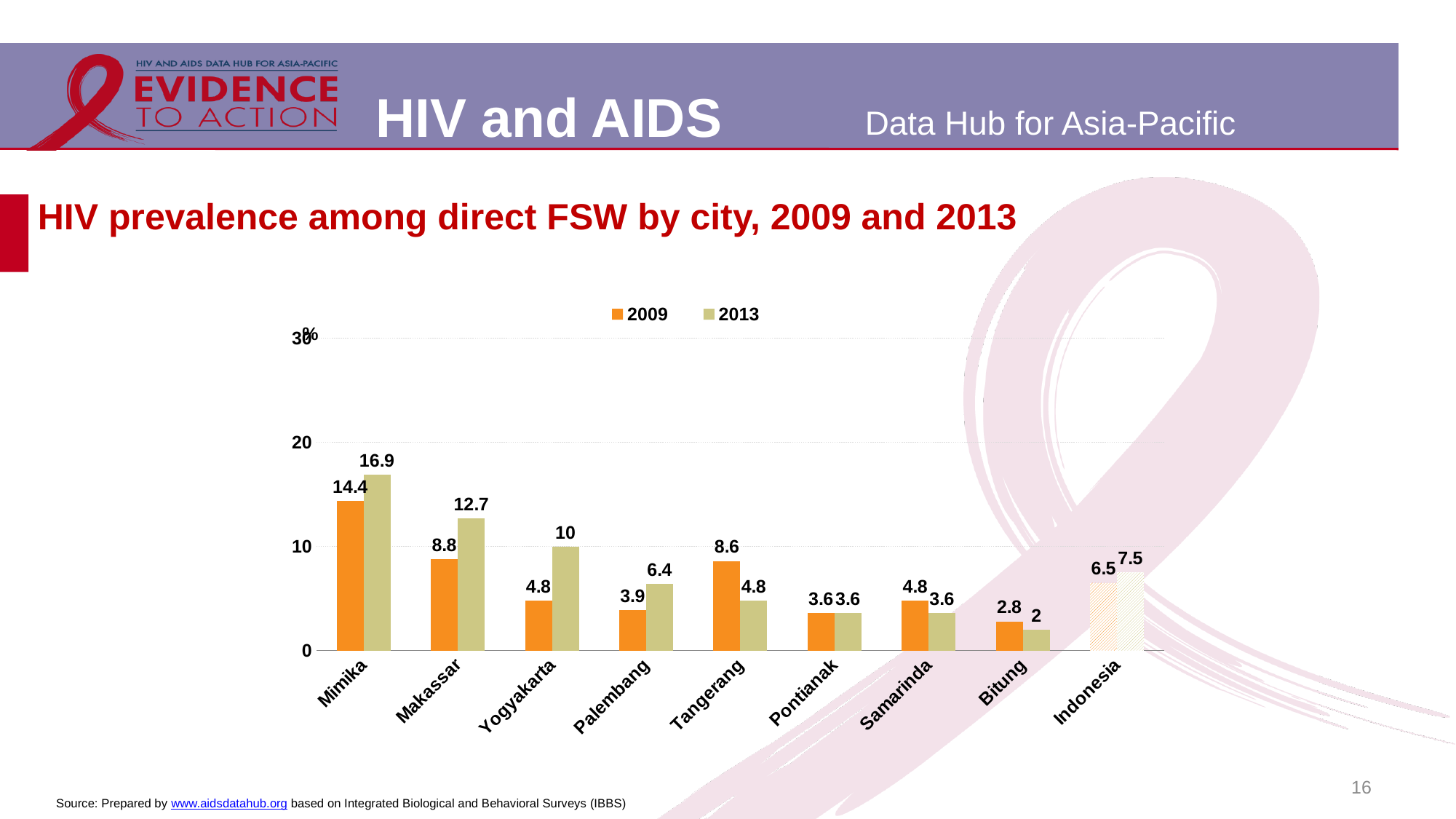
Which city has the lowest 2013 value? Bitung What is the 2013 value for Indonesia? 7.5 Which is larger for Tangerang, the 2009 value or the 2013 value? 2009 What is the 2013 value for Yogyakarta? 10 How many cities or categories are shown on the x axis? 9 What kind of chart is shown on the slide? Bar chart What is the 2009 value for Tangerang? 8.6 Which city has the highest 2013 value? Mimika How many series does the legend list? 2 What is the difference between the 2013 and 2009 values for Mimika? 2.5 What is the 2013 HIV prevalence value for Makassar? 12.7 What is the 2009 HIV prevalence value for Mimika? 14.4